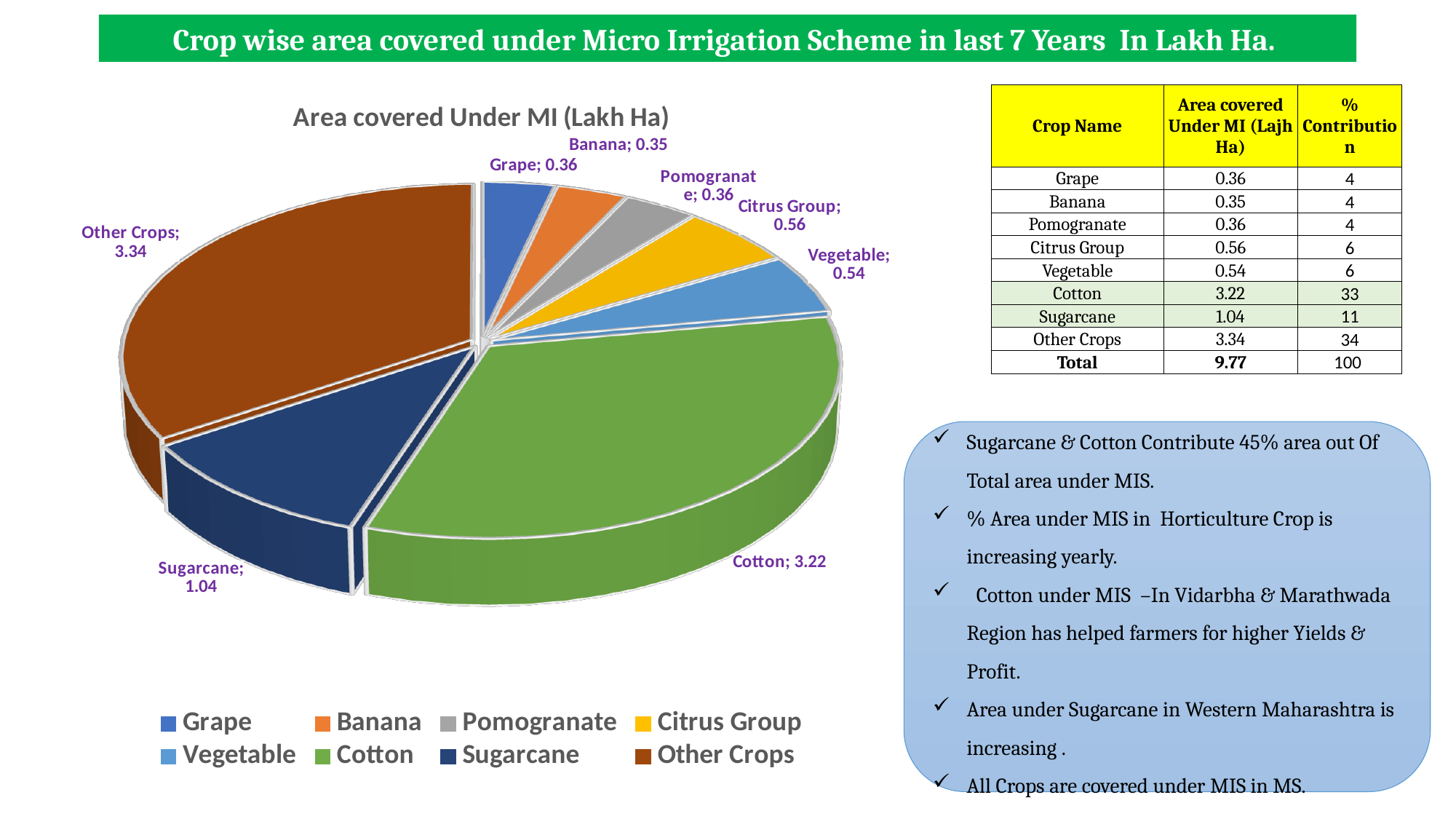
Which crop has the smallest area covered under MI? Banana What is the area covered under MI for Citrus Group? 0.56 Which crop has the largest area covered under MI? Other Crops Which has a larger area covered under MI, Sugarcane or Citrus Group? Sugarcane What is the difference between the area covered for Other Crops and Cotton? 0.12 What type of chart is shown on the slide? pie chart What is the area covered under MI for Vegetable? 0.54 What is the area covered under MI for Cotton? 3.22 What share of the total area does Cotton contribute, according to the table? 33 What is the title of the pie chart? Area covered Under MI (Lakh Ha) What is the area covered under MI for Sugarcane? 1.04 How many crop categories are shown in the pie chart? 8